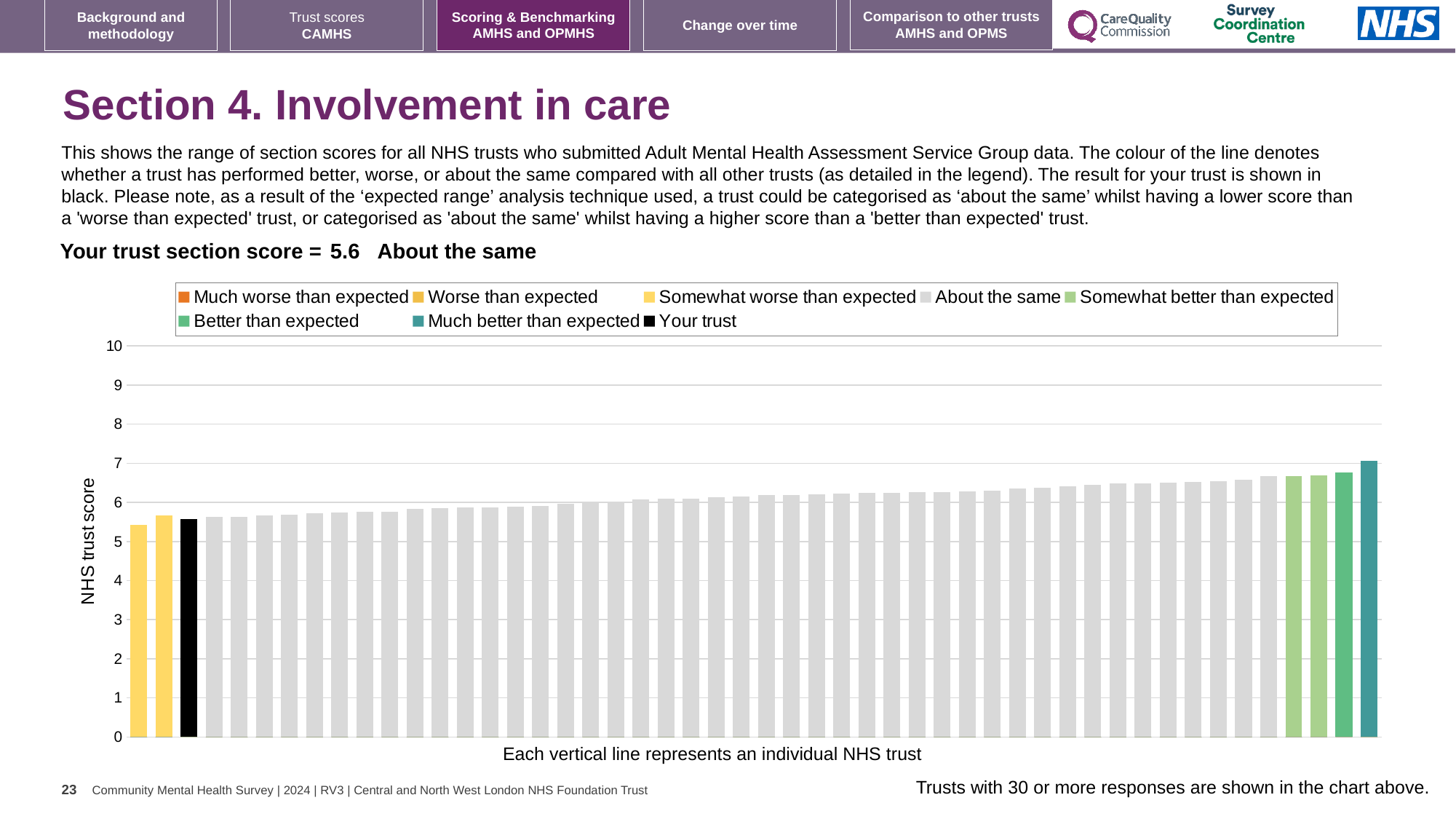
What is the section score for your trust shown on the slide? 5.6 Do the bar values rise or fall from left to right across the chart? rise What is the label on the vertical axis of the chart? NHS trust score Which legend category does the tallest bar in the chart belong to? Much better than expected Is the value of the black 'Your trust' bar greater or less than 6? less What kind of chart is shown on the slide? bar chart Is the value of the tallest bar in the chart greater or less than 6? greater Is the value of the black 'Your trust' bar greater or less than 5? greater How many entries does the chart legend list? 8 Is the 'Your trust' bar higher or lower than the first (leftmost) bar in the chart? higher What colour is the bar representing your trust in the chart? black